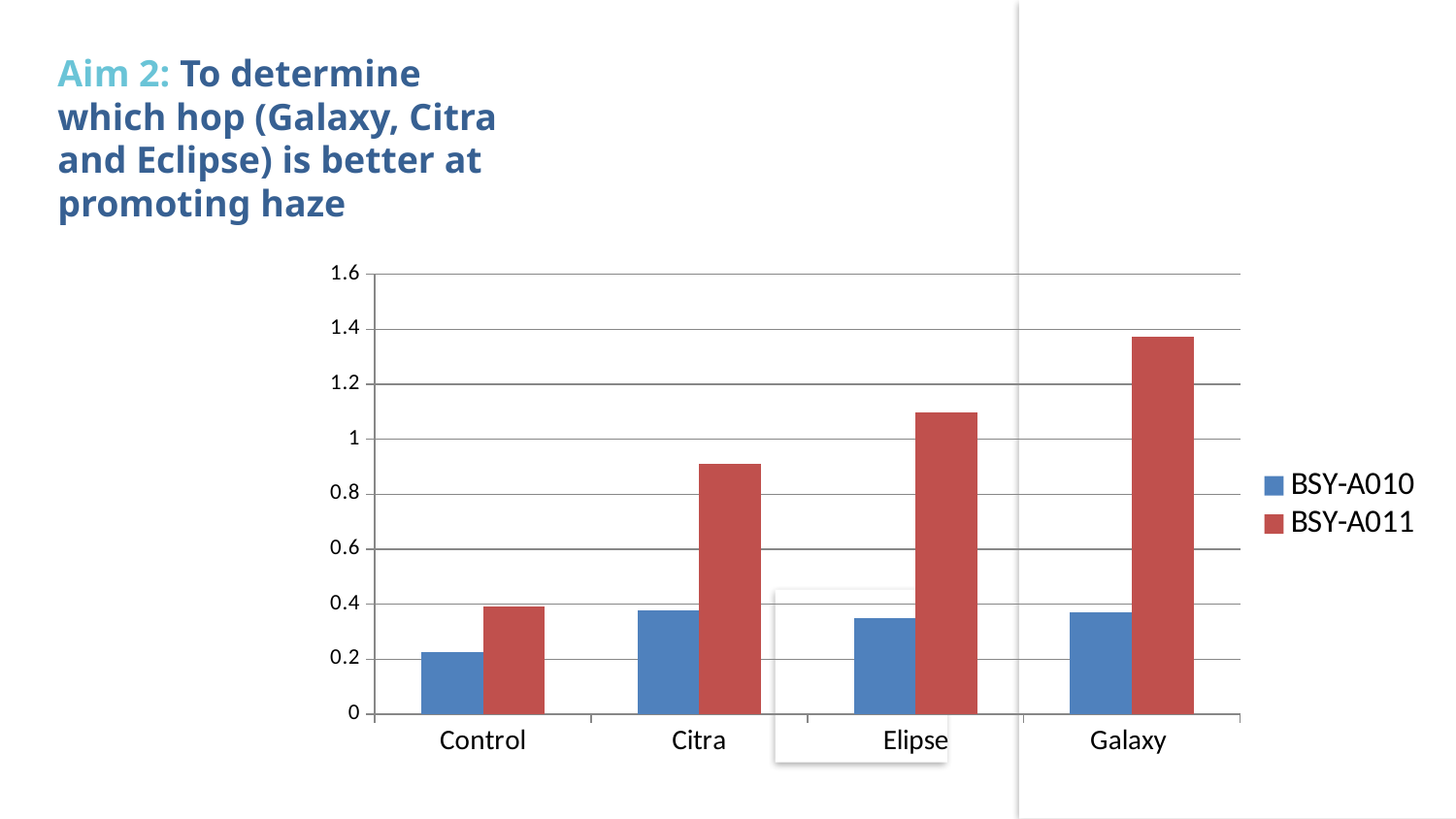
Which category has the lowest value for BSY-A010? Control Which colour represents BSY-A011 in the chart? red Is the value for BSY-A011 in Citra greater or less than 1? less Do the BSY-A011 values rise or fall moving from Control to Galaxy along the x axis? rise What kind of chart is shown on the slide? bar chart How many series does the chart's legend list? 2 Which category has the lowest value for BSY-A011? Control Is the value for BSY-A010 in Control greater or less than 0.4? less Is the value for BSY-A011 in Galaxy greater or less than 1.2? greater How many categories are shown on the x axis of the chart? 4 Which is larger in the Elipse category, BSY-A010 or BSY-A011? BSY-A011 Which category has the highest value for BSY-A011? Galaxy